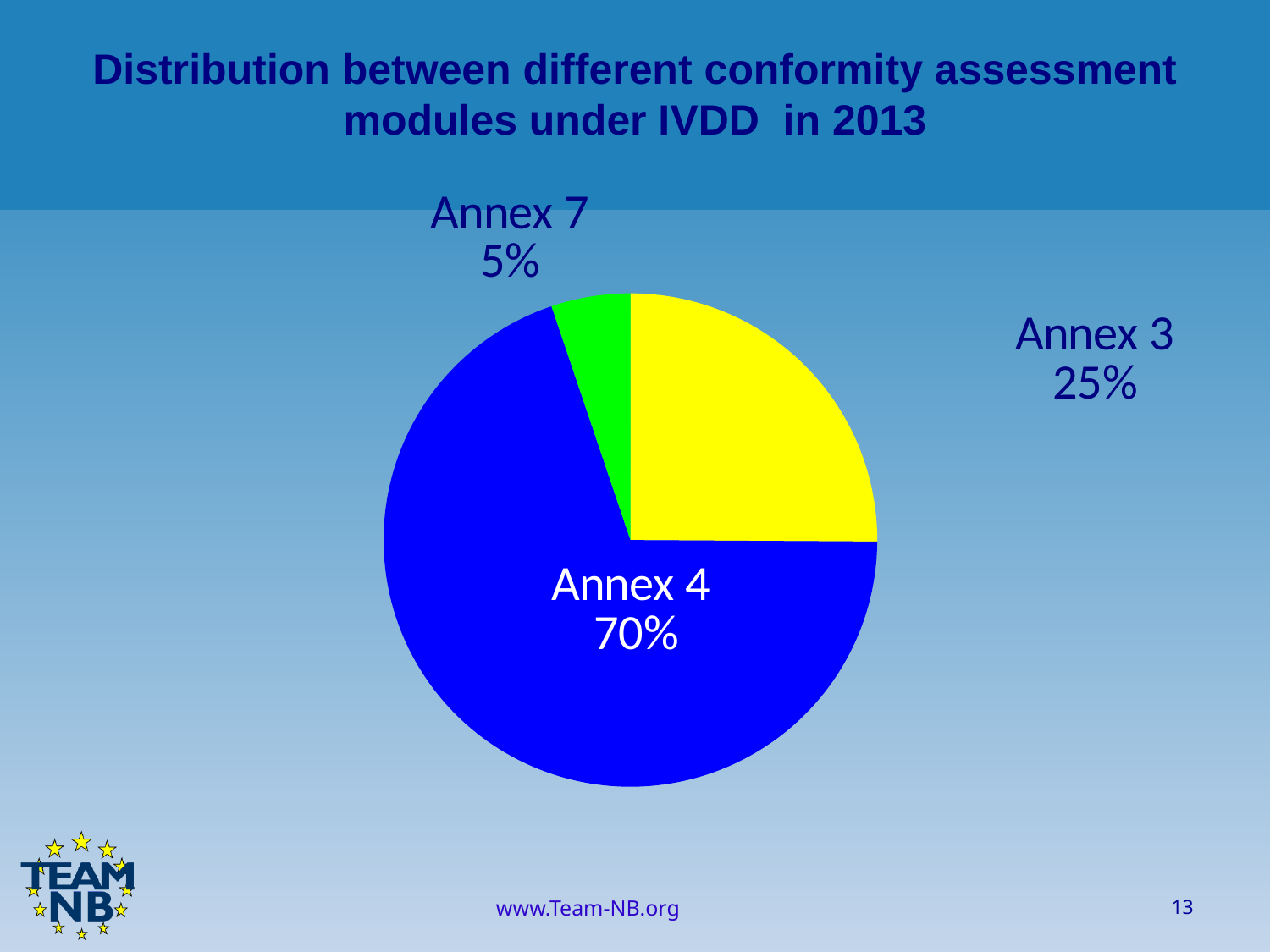
Which has a larger share, Annex 3 or Annex 7? Annex 3 What is the difference in percentage points between the Annex 3 and Annex 7 shares? 20 Which annex has the largest share of the pie? Annex 4 What colour is the Annex 4 slice? blue What share of the pie does Annex 4 represent? 70% What share of the pie does Annex 3 represent? 25% Which annex has the smallest share of the pie? Annex 7 What kind of chart is shown on the slide? pie chart How many slices does the pie chart have? 3 What is the title of the chart? Distribution between different conformity assessment modules under IVDD in 2013 What is the difference in percentage points between the Annex 4 and Annex 3 shares? 45 What share of the pie does Annex 7 represent? 5%